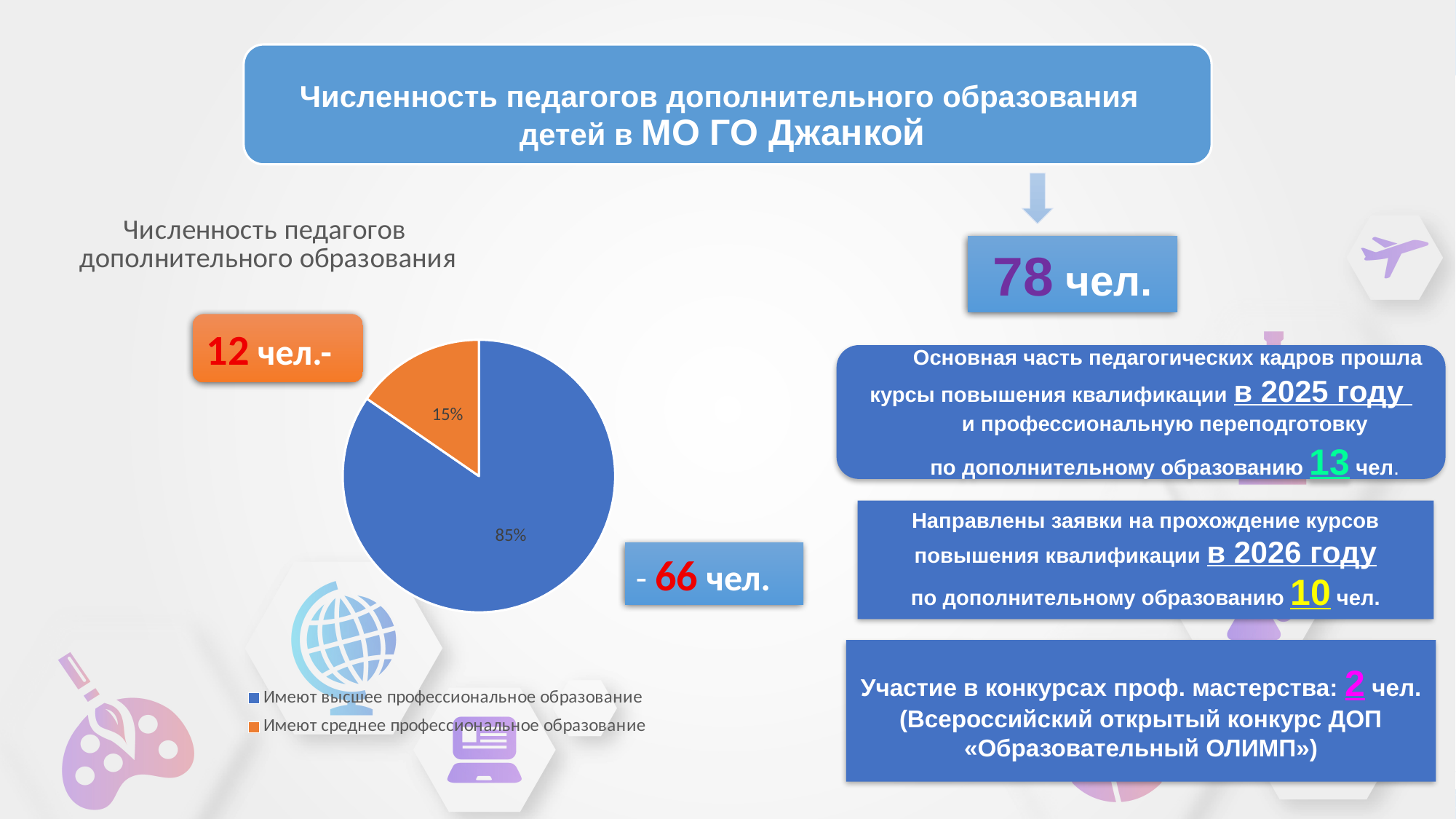
What percentage of the pie is labelled for "Имеют высшее профессиональное образование"? 85% What colour is the slice for "Имеют среднее профессиональное образование"? orange What type of chart is shown on the slide? pie chart What percentage of the pie is labelled for "Имеют среднее профессиональное образование"? 15% Which slice is larger: "Имеют высшее профессиональное образование" or "Имеют среднее профессиональное образование"? Имеют высшее профессиональное образование Which category has the largest share of the pie? Имеют высшее профессиональное образование How many slices does the pie chart have? 2 How many entries does the chart legend list? 2 What is the difference in percentage points between the two slices of the pie chart? 70 Which category has the smallest share of the pie? Имеют среднее профессиональное образование Is the share for "Имеют среднее профессиональное образование" greater or less than 50%? less What is the title of the chart on the slide? Численность педагогов дополнительного образования